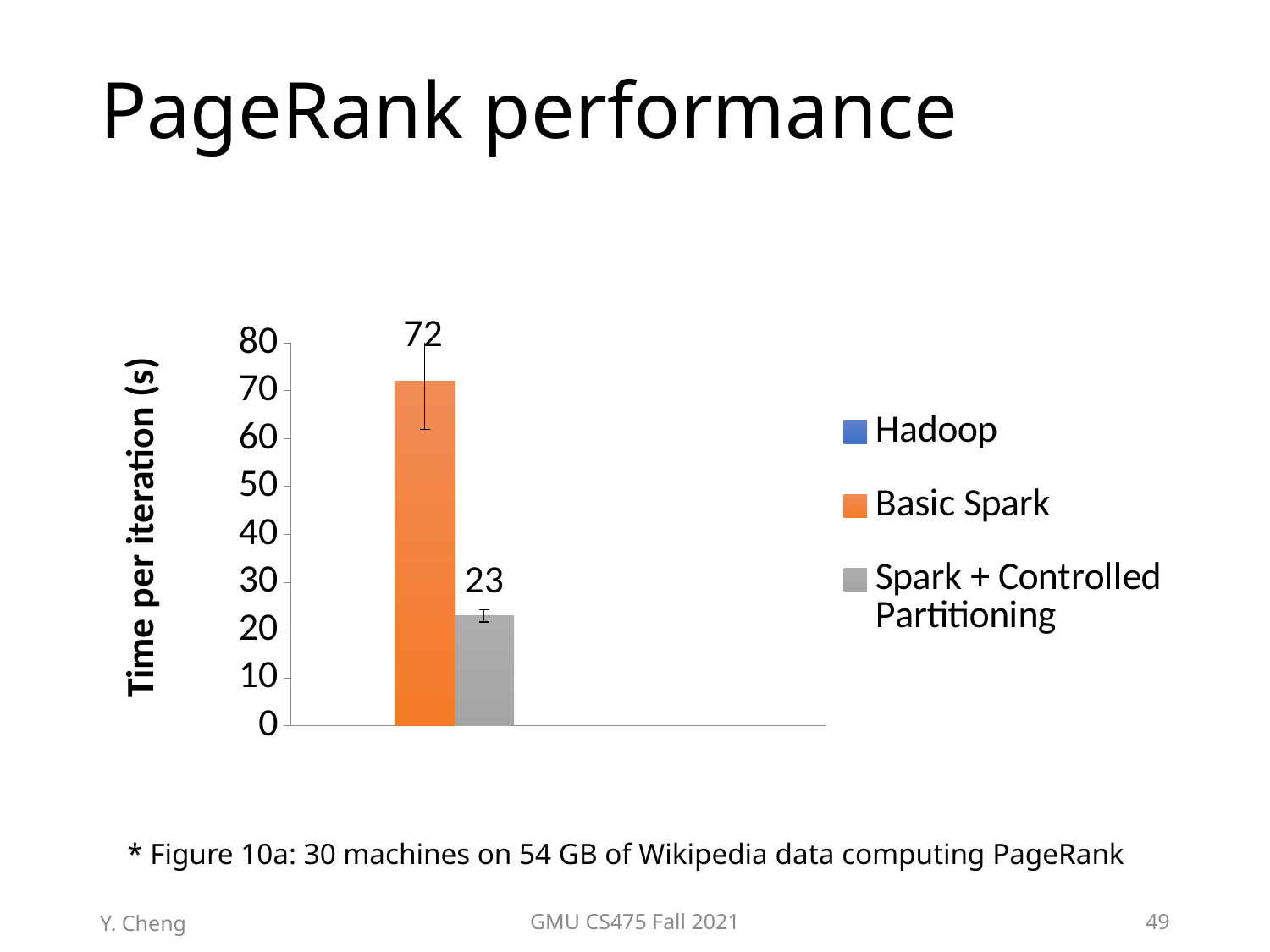
What is the time per iteration for Spark + Controlled Partitioning? 23 Which plotted series has the highest time per iteration? Basic Spark How many series does the legend list? 3 Is the value for Basic Spark greater or less than 60? greater Is the value for Spark + Controlled Partitioning greater or less than 30? less What is the difference in time per iteration between Basic Spark and Spark + Controlled Partitioning? 49 Which plotted series has the lowest time per iteration? Spark + Controlled Partitioning What is the label of the vertical axis? Time per iteration (s) Which has a larger time per iteration, Basic Spark or Spark + Controlled Partitioning? Basic Spark What kind of chart is shown on the slide? Bar chart What is the time per iteration for Basic Spark? 72 What colour is the Basic Spark bar? Orange